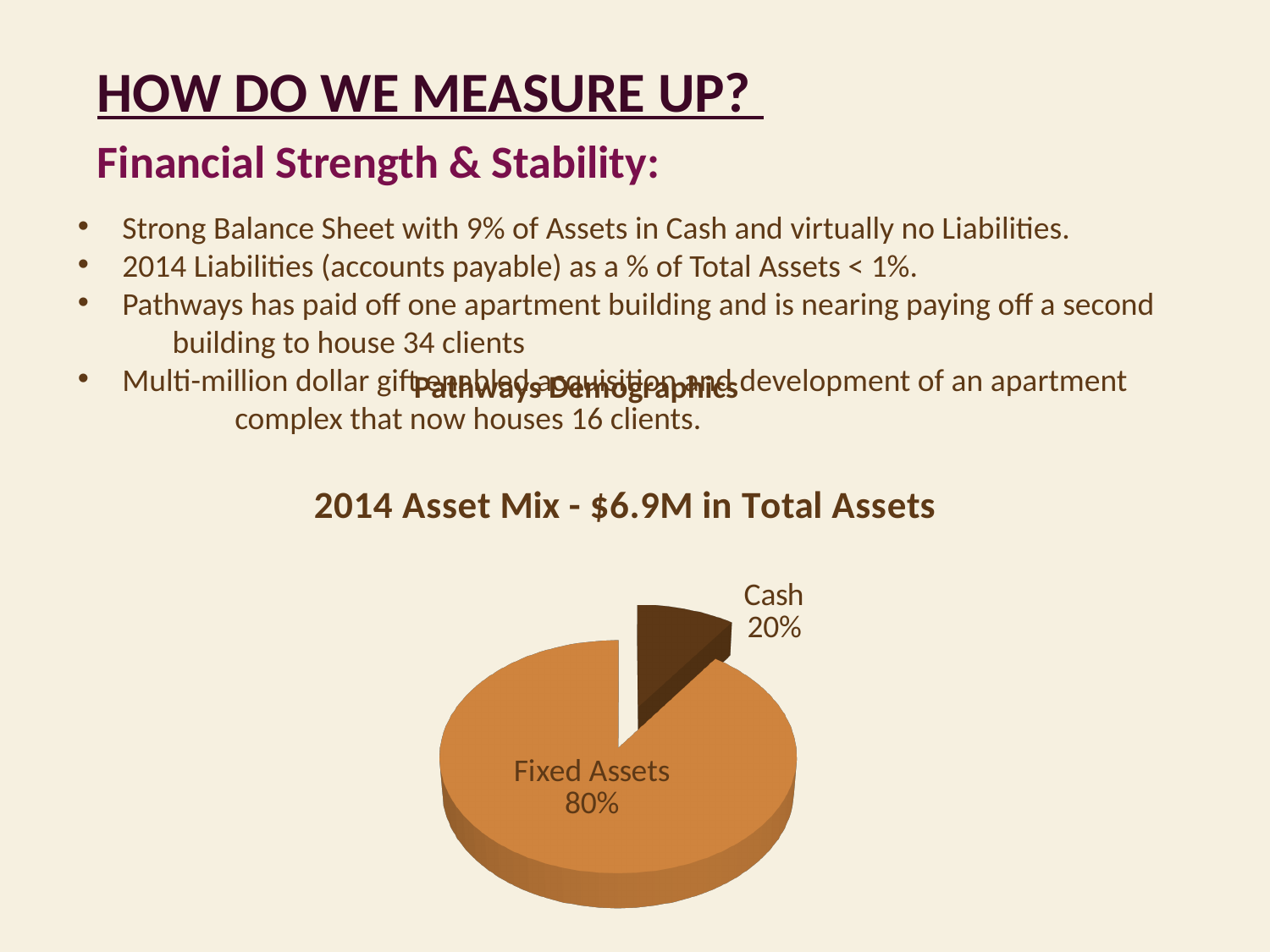
What is the total of the two slice percentages shown on the pie chart? 100% What kind of chart is shown on the slide? pie chart Which is larger, the Cash slice or the Fixed Assets slice? Fixed Assets What share of the pie is Fixed Assets? 80% Which slice of the pie is the largest? Fixed Assets What share of the pie is Cash? 20% Which slice is pulled out (exploded) from the pie? Cash How many slices does the pie chart have? 2 What is the difference in percentage points between the Fixed Assets slice and the Cash slice? 60 Which slice of the pie is the smallest? Cash What is the title of the chart? 2014 Asset Mix - $6.9M in Total Assets